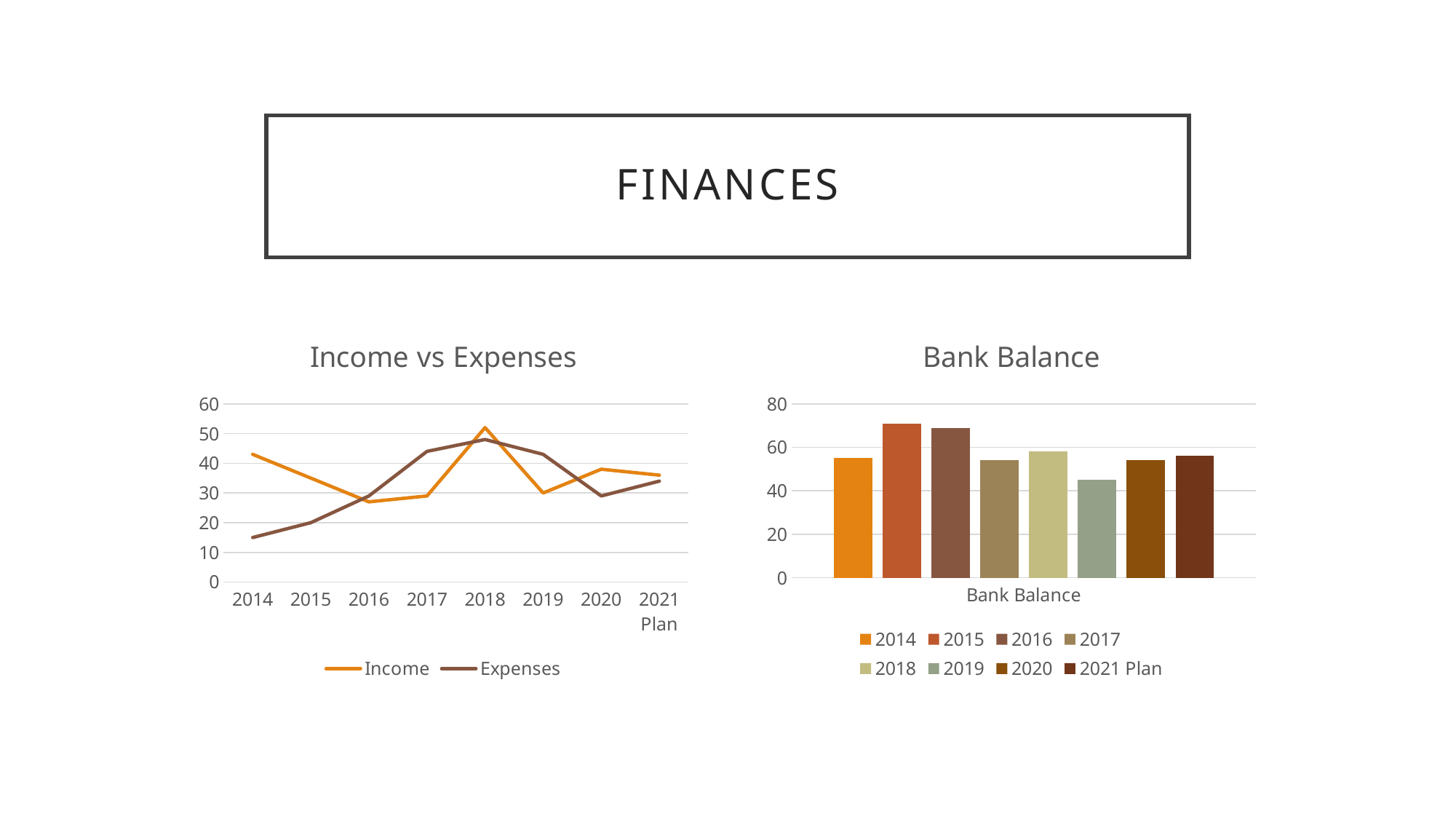
In the Income vs Expenses chart, which is larger in 2017, Income or Expenses? Expenses In the Income vs Expenses chart, in which year are Expenses lowest? 2014 In the Bank Balance chart, how many series does the legend list? 8 In the Income vs Expenses chart, do Expenses rise or fall from 2014 to 2018? rise In the Bank Balance chart, which year has the lowest bank balance? 2019 In the Bank Balance chart, is the value for 2019 greater or less than 50? less In the Income vs Expenses chart, is the Income value for 2014 greater or less than 40? greater In the Income vs Expenses chart, in which year is Income highest? 2018 What kind of chart is the Bank Balance chart? bar chart What kind of chart is the Income vs Expenses chart? line chart In the Income vs Expenses chart, how many categories are shown on the x axis? 8 In the Income vs Expenses chart, how many series does the legend list? 2